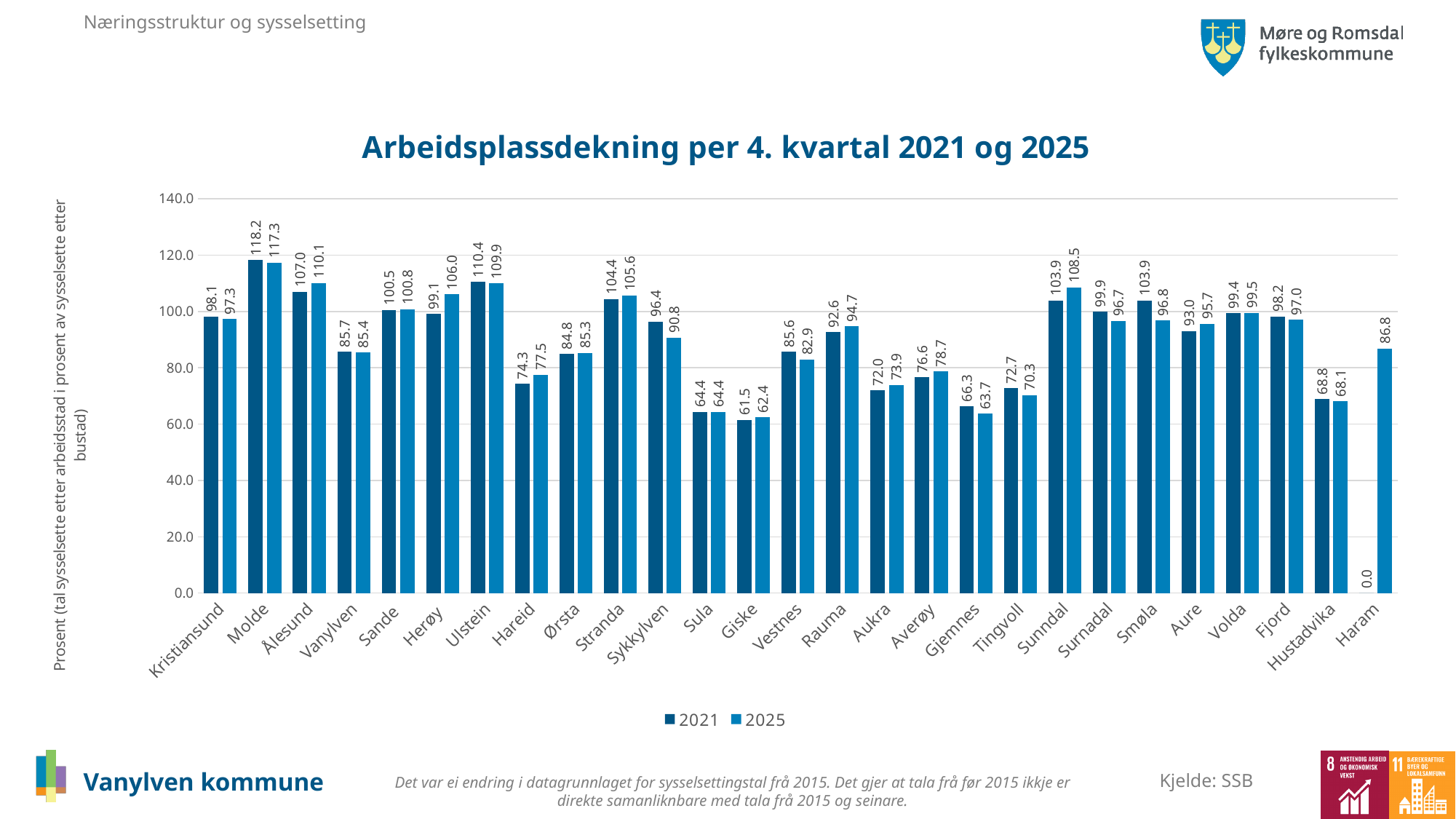
What is the difference between the 2021 and 2025 values for Herøy? 6.9 What kind of chart is shown on the slide? Bar chart Which municipality has the lowest value in the 2025 series? Giske Which municipality has the highest value in the 2021 series? Molde Which is larger for Sykkylven, the 2021 value or the 2025 value? 2021 Is the value for Sunndal in 2025 greater or less than 100.0? greater What is the value for Molde in 2021? 118.2 What is the title of the chart? Arbeidsplassdekning per 4. kvartal 2021 og 2025 How many municipalities are shown on the x axis? 27 What is the value for Vanylven in 2025? 85.4 What is the value for Haram in 2025? 86.8 How many series does the legend list? 2